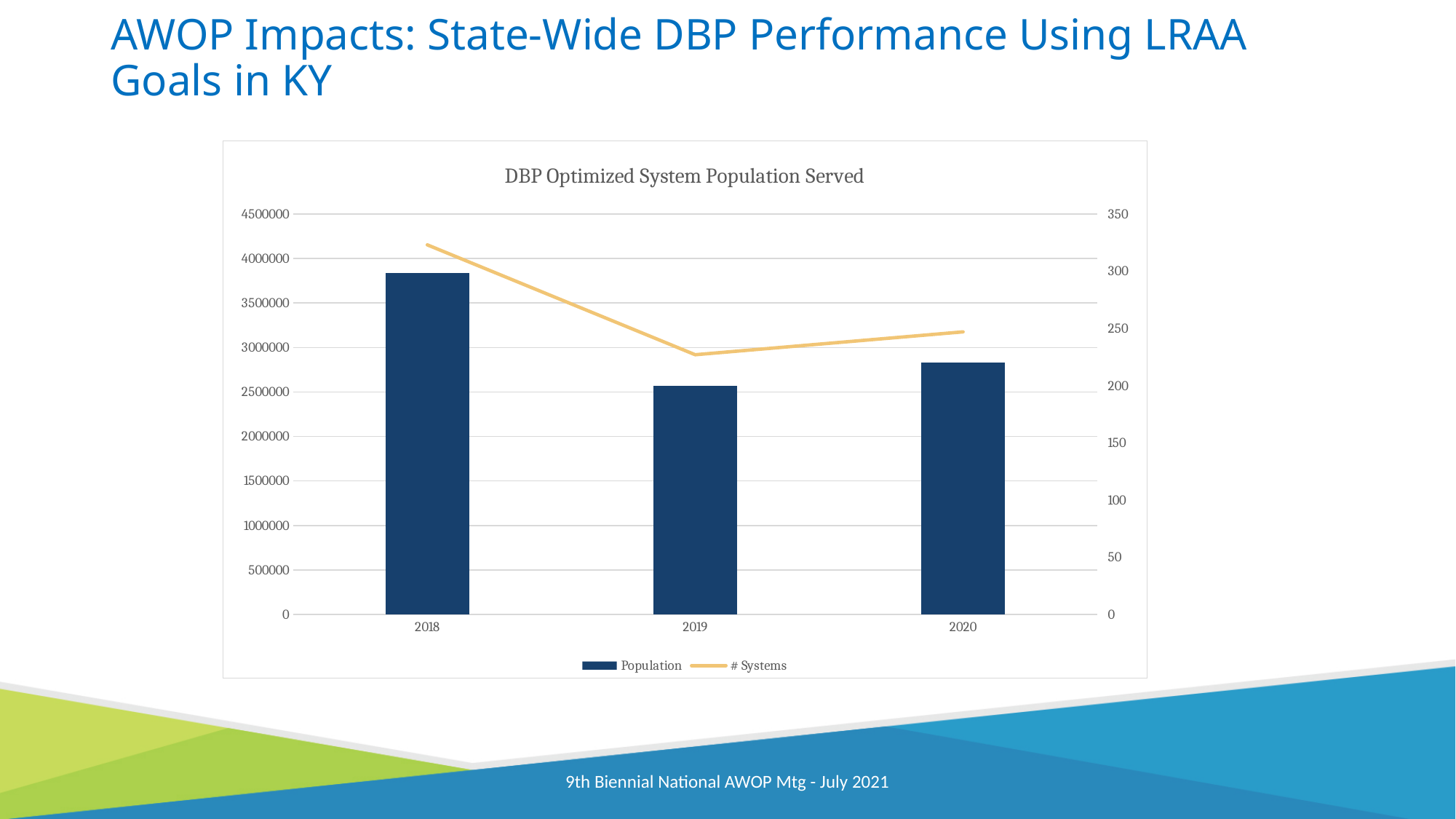
Is the Population value for 2018 greater or less than 3500000? greater Is the Population value for 2019 greater or less than 3000000? less Is the # Systems value for 2019 greater or less than 250? less Which year has a larger Population value, 2019 or 2020? 2020 How many series does the chart legend list? 2 How many years are shown on the x axis of the chart? 3 Which year has the highest Population bar? 2018 Which series is drawn as a line rather than bars? # Systems What is the title of the chart? DBP Optimized System Population Served Does the # Systems line rise or fall from 2018 to 2019? fall Which year has the lowest Population bar? 2019